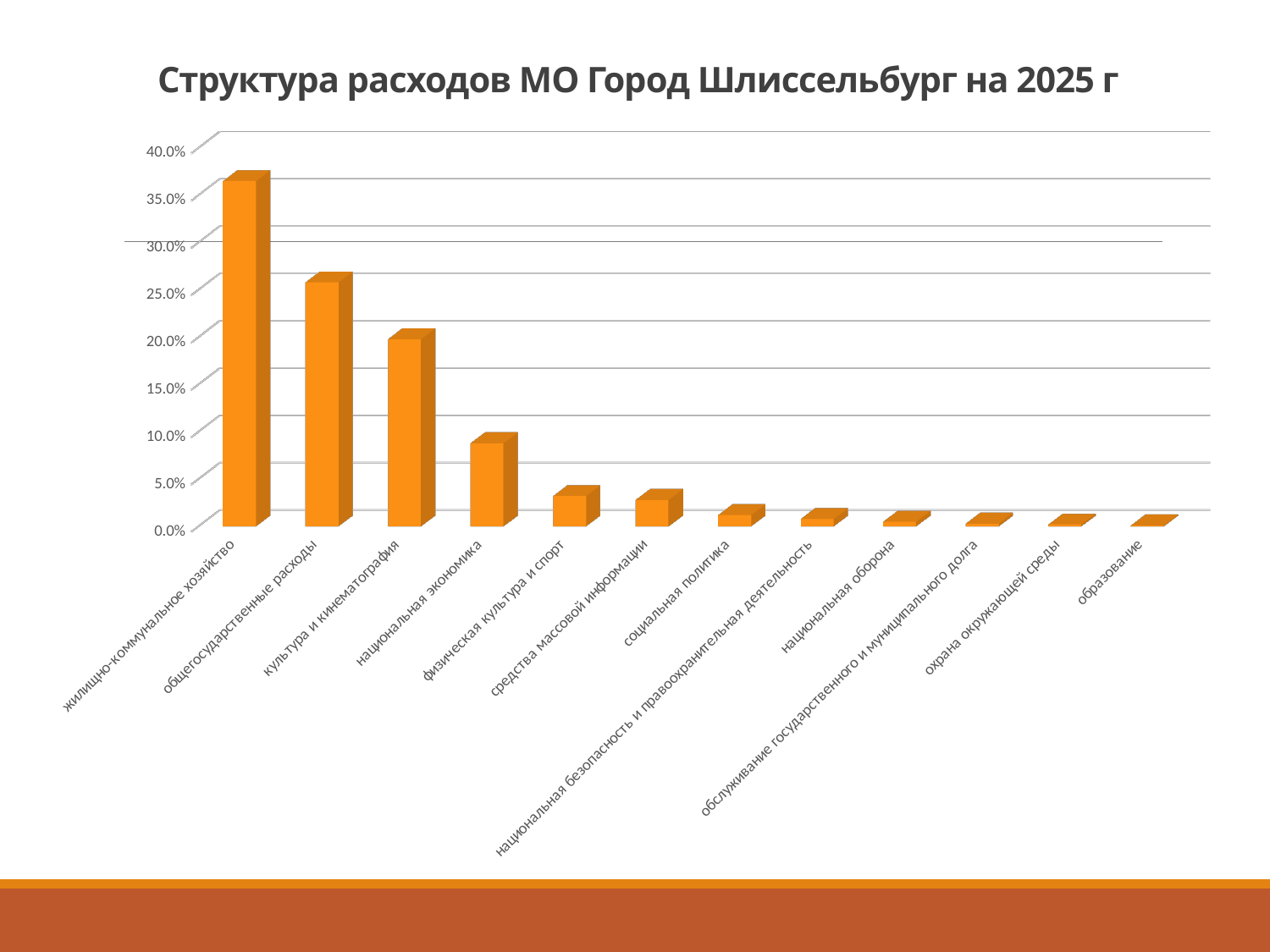
Do the values rise or fall moving from left to right along the x axis? fall What kind of chart is shown on the slide? bar chart What is the title of the chart? Структура расходов МО Город Шлиссельбург на 2025 г Is the value for культура и кинематография greater or less than 25.0%? less Is the value for жилищно-коммунальное хозяйство greater or less than 30.0%? greater Which is larger, the value for культура и кинематография or the value for национальная экономика? культура и кинематография Is the value for национальная экономика greater or less than 15.0%? less Which category has the highest value? жилищно-коммунальное хозяйство How many categories are plotted on the x axis? 12